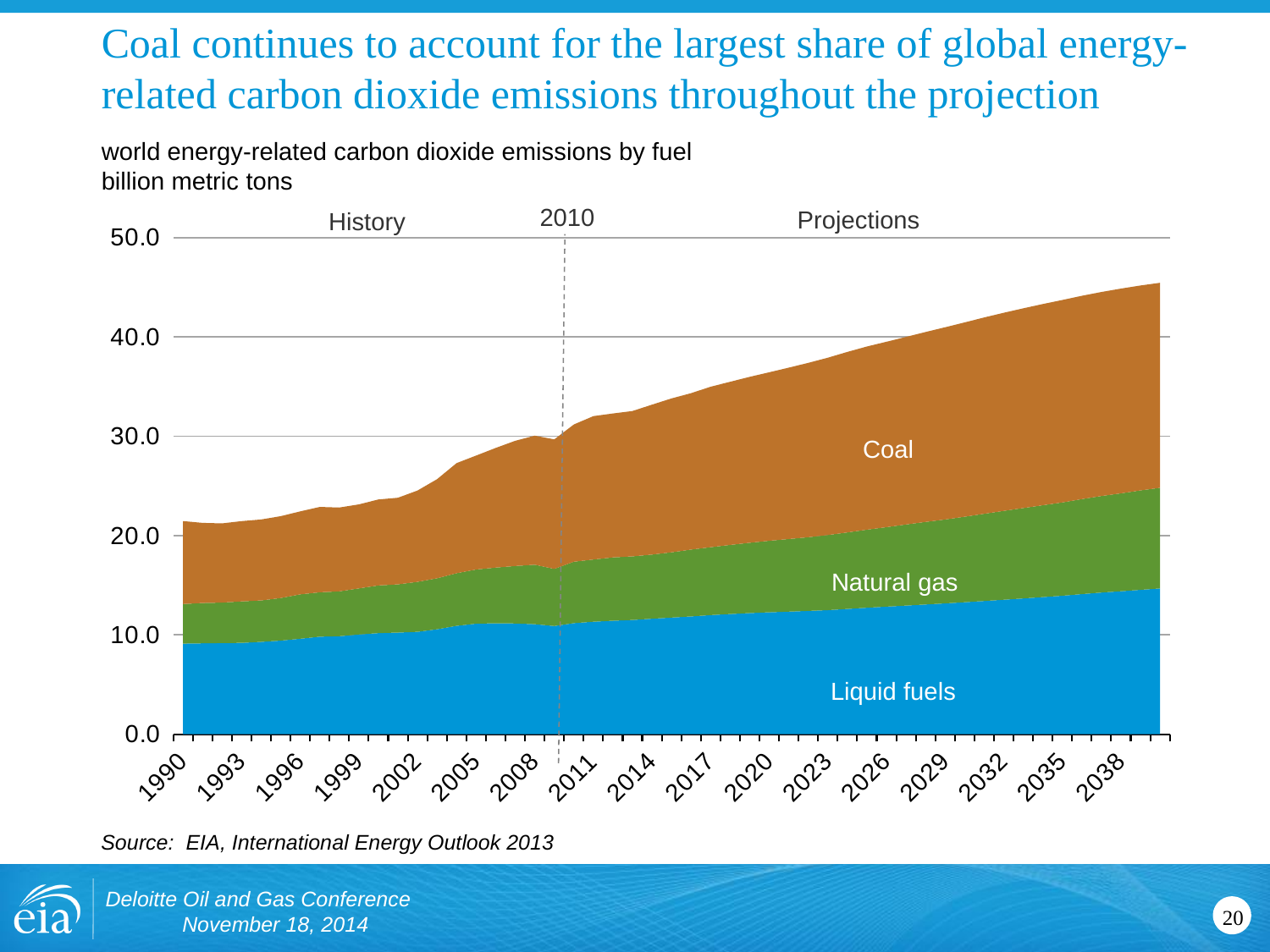
Is the total emissions value in 1990 greater or less than 30 billion metric tons? less How many fuel series are plotted in the chart? 3 Is the total emissions value at the end of the projection (2040) greater or less than 40 billion metric tons? greater Do total world energy-related carbon dioxide emissions rise or fall from 1990 to 2040? Rise In what unit are the emissions measured on the chart? billion metric tons Which year marks the boundary between History and Projections on the chart? 2010 Which fuel accounts for the smallest share of emissions in the projection period? Natural gas How many year labels are shown along the x axis? 17 Is the total emissions value in 2020 greater or less than 30 billion metric tons? greater What kind of chart is shown on the slide? Stacked area chart In 2040, which contributes more emissions: Coal or Natural gas? Coal